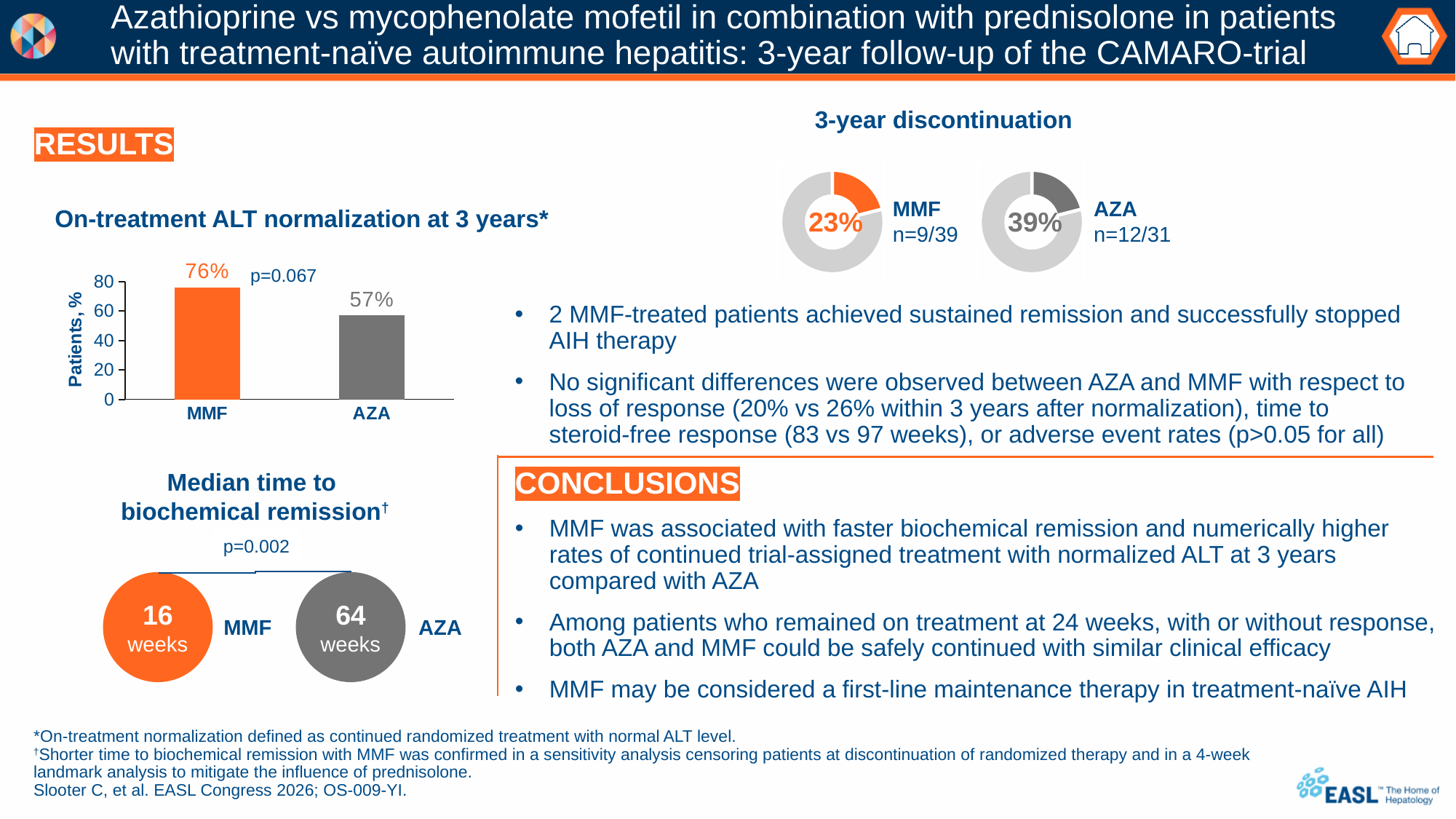
How many bars are shown in the 'On-treatment ALT normalization at 3 years' chart? 2 In the 'On-treatment ALT normalization at 3 years' chart, what is the value for AZA? 57% In the '3-year discontinuation' donut charts, what percentage is shown for AZA? 39% What kind of chart is 'On-treatment ALT normalization at 3 years'? bar chart In the '3-year discontinuation' donut charts, what percentage is shown for MMF? 23% In the '3-year discontinuation' donut charts, which group has the higher discontinuation rate? AZA In the 'On-treatment ALT normalization at 3 years' chart, which group has the higher value? MMF What is the y-axis label of the 'On-treatment ALT normalization at 3 years' chart? Patients, % In the 'On-treatment ALT normalization at 3 years' chart, what is the value for MMF? 76% In the 'On-treatment ALT normalization at 3 years' chart, is the value for AZA greater or less than 60? less In the 'On-treatment ALT normalization at 3 years' chart, what is the difference in percentage points between MMF and AZA? 19 What p-value is shown on the 'On-treatment ALT normalization at 3 years' chart? p=0.067